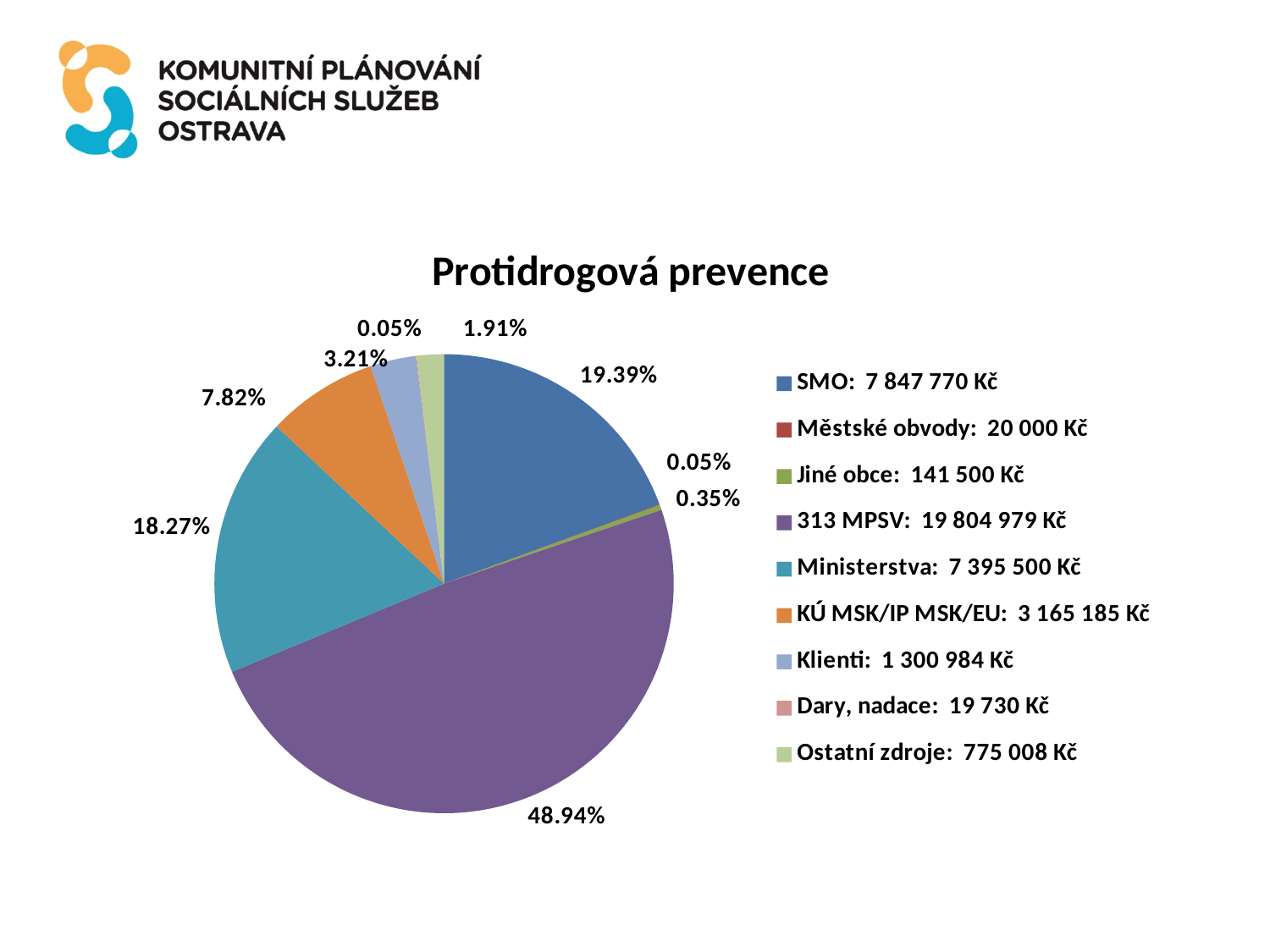
Which is larger, the amount for SMO or the amount for Ministerstva? SMO What amount does the legend give for Klienti? 1 300 984 Kč What share of the pie does the 313 MPSV slice represent? 48.94% What amount does the legend give for 313 MPSV? 19 804 979 Kč What is the difference between the amount for SMO and the amount for Ministerstva? 452 270 Kč What is the title of the pie chart? Protidrogová prevence What amount does the legend give for Ministerstva? 7 395 500 Kč Which source has the largest slice of the pie? 313 MPSV What kind of chart is shown on the slide? pie chart What share of the pie does the SMO slice represent? 19.39% How many entries does the legend of the pie chart list? 9 What is the difference in percentage share between the 313 MPSV slice and the Ministerstva slice? 30.67%